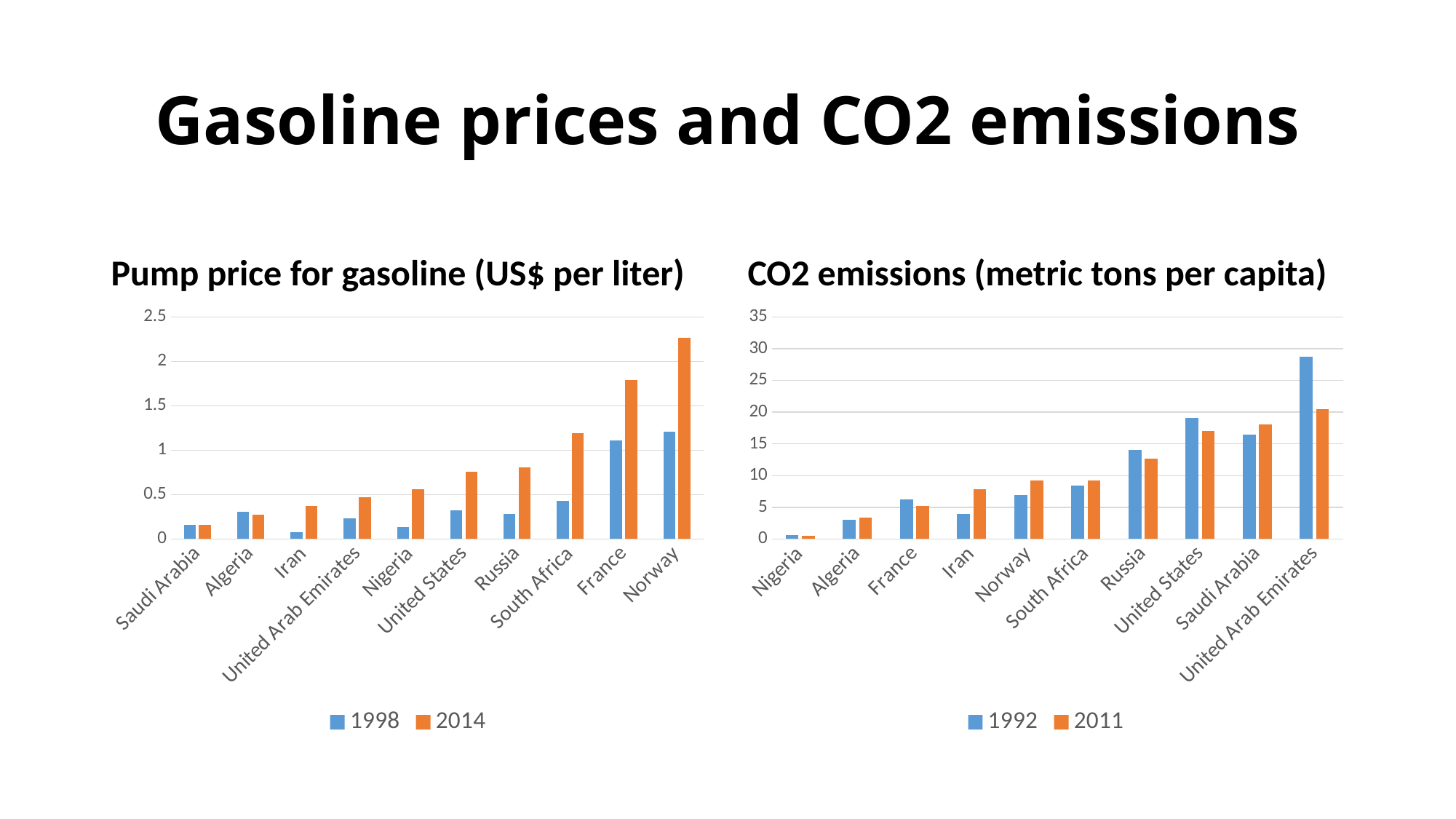
On the "Pump price for gasoline (US$ per liter)" chart, is the 2014 value for Saudi Arabia greater or less than 0.5? less How many countries are shown on the "Pump price for gasoline (US$ per liter)" chart? 10 On the "CO2 emissions (metric tons per capita)" chart, is the 1992 value for United Arab Emirates greater or less than 25? greater On the "CO2 emissions (metric tons per capita)" chart, do the 2011 values rise or fall from Nigeria to United Arab Emirates along the x axis? rise On the "Pump price for gasoline (US$ per liter)" chart, is the 2014 value for Norway greater or less than 2? greater What type of chart is the "Pump price for gasoline (US$ per liter)" chart? bar chart How many series does the legend of the "CO2 emissions (metric tons per capita)" chart list? 2 On the "CO2 emissions (metric tons per capita)" chart, which country has the highest 1992 value? United Arab Emirates On the "Pump price for gasoline (US$ per liter)" chart, which country has the lowest 1998 value? Iran On the "CO2 emissions (metric tons per capita)" chart, which is larger for the United States: the 1992 value or the 2011 value? 1992 On the "CO2 emissions (metric tons per capita)" chart, which country has the lowest 2011 value? Nigeria On the "Pump price for gasoline (US$ per liter)" chart, which country has the highest 2014 value? Norway